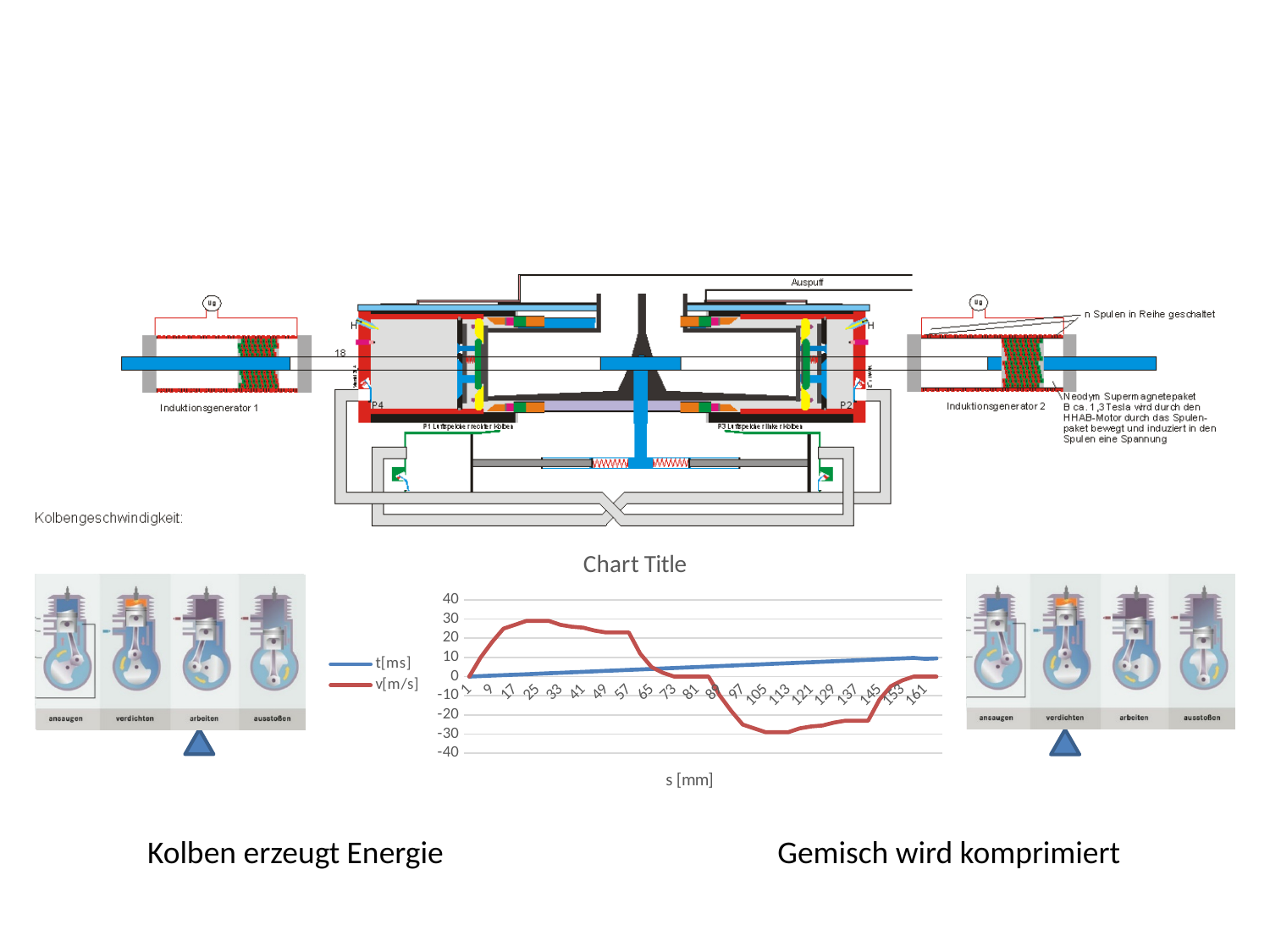
What is the label of the horizontal axis of the chart? s [mm] Which is larger, the value of v[m/s] at s = 25 or at s = 105? s = 25 Is the value of t[ms] at s = 81 greater or less than 10? less What is the lowest value shown on the vertical axis of the chart? -40 What is the highest value shown on the vertical axis of the chart? 40 What are the two series named in the chart legend? t[ms] and v[m/s] Which series reaches the higher peak value, t[ms] or v[m/s]? v[m/s] Is the value of v[m/s] at s = 105 greater or less than -20? less Does the t[ms] series rise or fall as s increases along the x axis? rise Is the value of v[m/s] at s = 17 greater or less than 10? greater What kind of chart is shown on the slide? line chart How many series does the chart legend list? 2